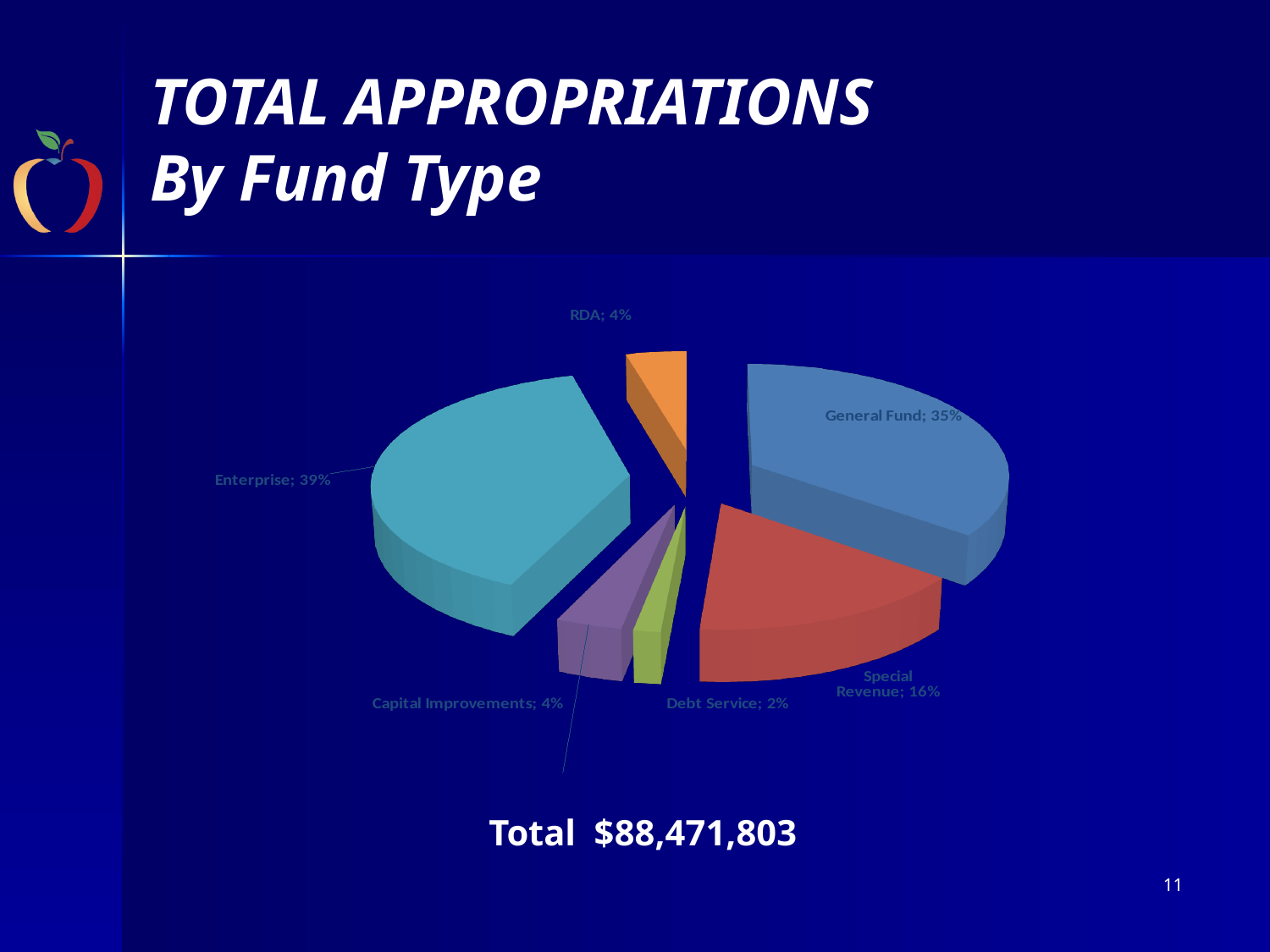
What share does Special Revenue represent? 16% What total dollar amount is stated below the chart? $88,471,803 What percentage is shown for Debt Service? 2% Which fund type has the smallest share of total appropriations? Debt Service How many fund types are shown in the pie chart? 6 Which fund type has the largest share of total appropriations? Enterprise What is the combined share of Capital Improvements and RDA? 8% What percentage of the pie is the General Fund? 35% What is the difference in percentage points between the Enterprise and General Fund shares? 4 Which is larger, the share for Special Revenue or the share for RDA? Special Revenue What kind of chart is shown on the slide? Pie chart What share of total appropriations does the Enterprise fund type account for? 39%